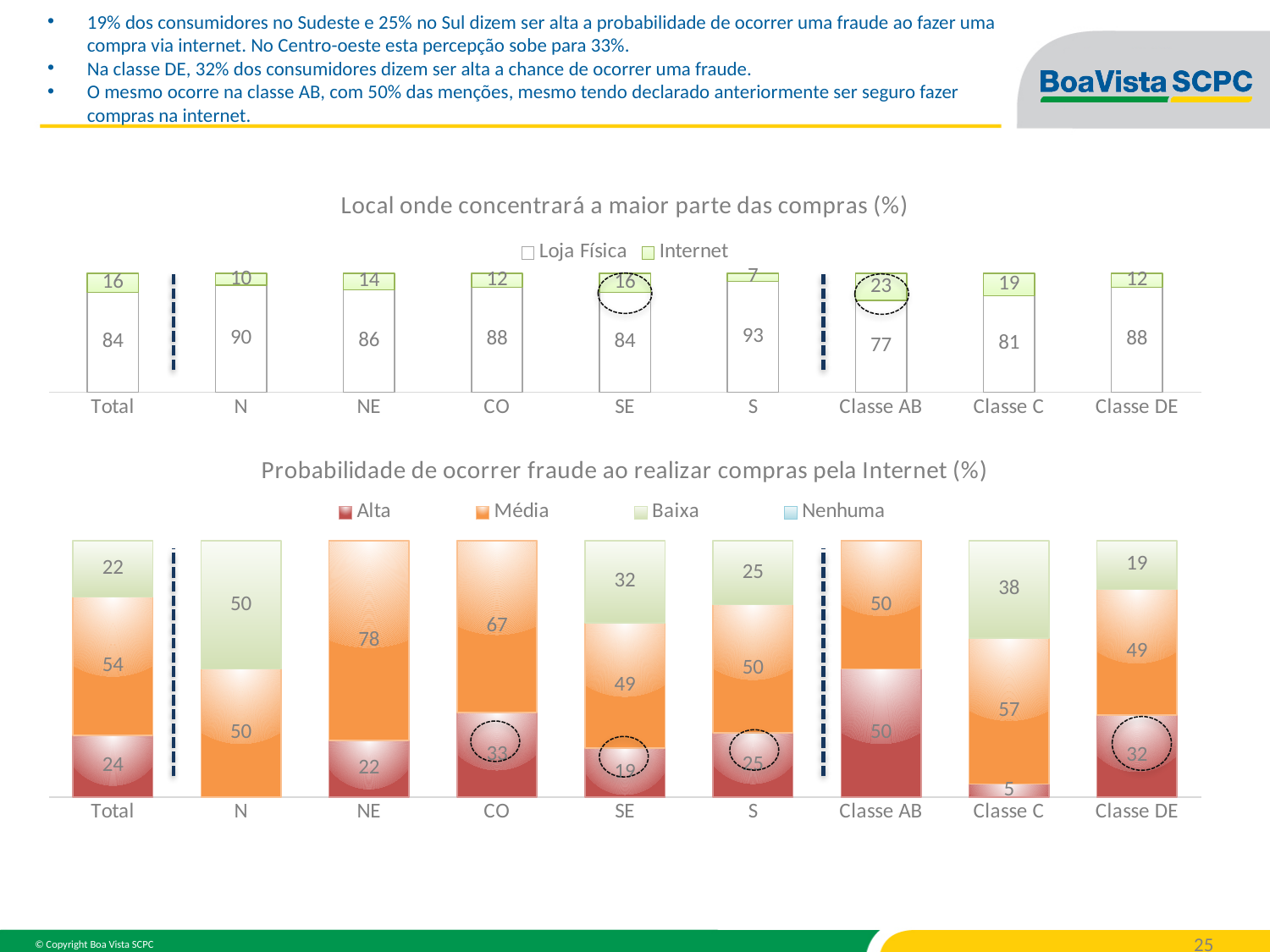
In the chart 'Probabilidade de ocorrer fraude ao realizar compras pela Internet (%)', what is the difference between the Alta values for Classe DE and SE? 13 In the chart 'Probabilidade de ocorrer fraude ao realizar compras pela Internet (%)', what is the Média value for NE? 78 In the chart 'Probabilidade de ocorrer fraude ao realizar compras pela Internet (%)', which is larger, the Baixa value for Classe C or for SE? Classe C In the chart 'Local onde concentrará a maior parte das compras (%)', how many series does the legend list? 2 What kind of chart is 'Probabilidade de ocorrer fraude ao realizar compras pela Internet (%)'? Stacked bar chart In the chart 'Local onde concentrará a maior parte das compras (%)', which category has the lowest Internet value? S In the chart 'Local onde concentrará a maior parte das compras (%)', what is the Loja Física value for S? 93 In the chart 'Probabilidade de ocorrer fraude ao realizar compras pela Internet (%)', how many series does the legend list? 4 In the chart 'Probabilidade de ocorrer fraude ao realizar compras pela Internet (%)', which category has the highest Alta value? Classe AB In the chart 'Probabilidade de ocorrer fraude ao realizar compras pela Internet (%)', what is the Alta value for Classe C? 5 In the chart 'Local onde concentrará a maior parte das compras (%)', which category has the highest Loja Física value? S In the chart 'Local onde concentrará a maior parte das compras (%)', what is the Internet value for Classe AB? 23